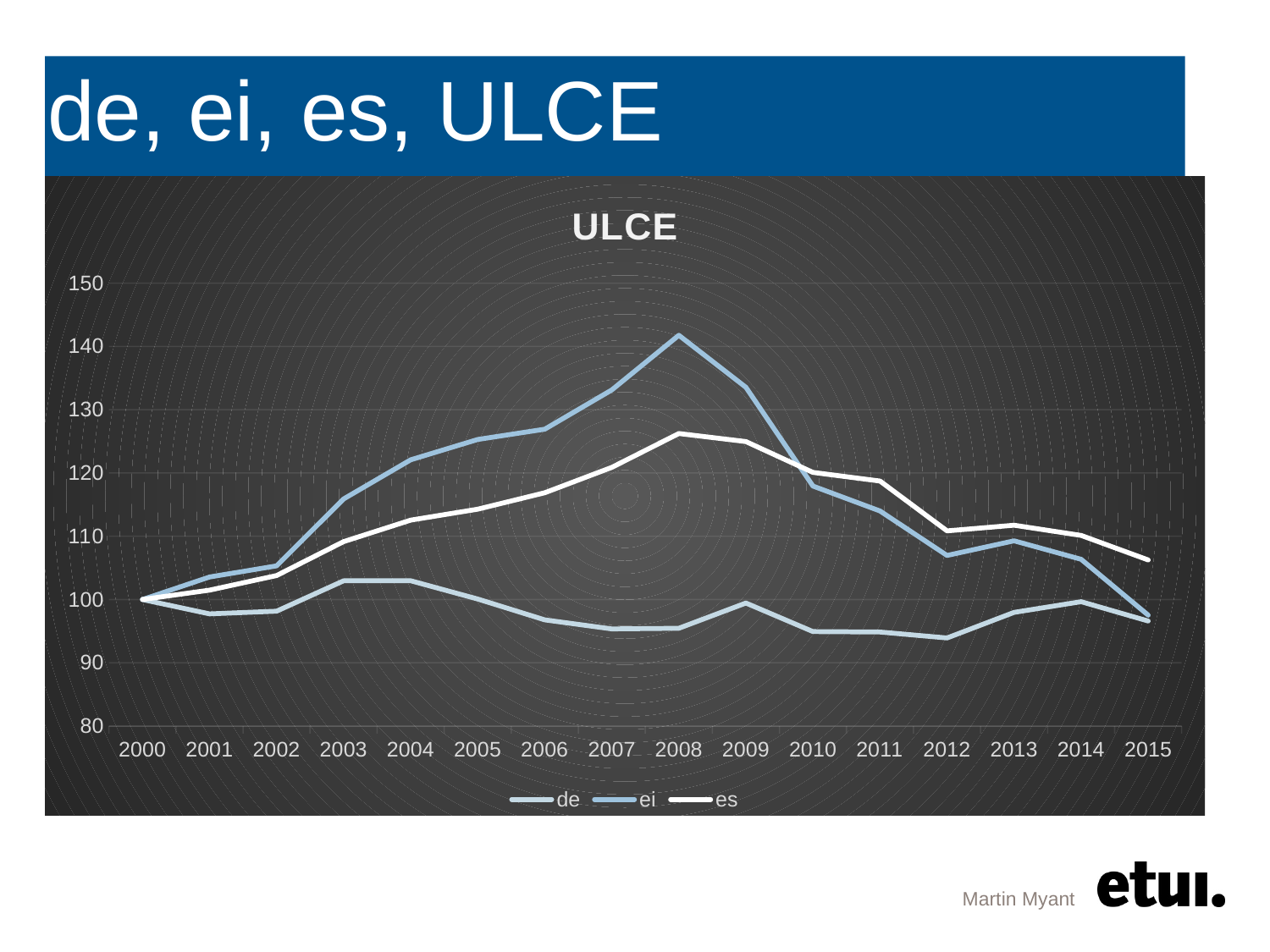
Does the ei series rise or fall from 2008 to 2015? fall In 2008, which series has the larger value, ei or es? ei In which year does the ei series reach its highest value? 2008 Is the value for ei in 2008 greater or less than 130? greater How many series does the legend list? 3 What is the title of the chart? ULCE What is the value of the ei series in 2000? 100 What kind of chart is shown on the slide? line chart What are the three series named in the legend? de, ei, es How many years are shown along the x axis? 16 Which series has the lowest value in 2012? de Is the value for de in 2012 greater or less than 100? less